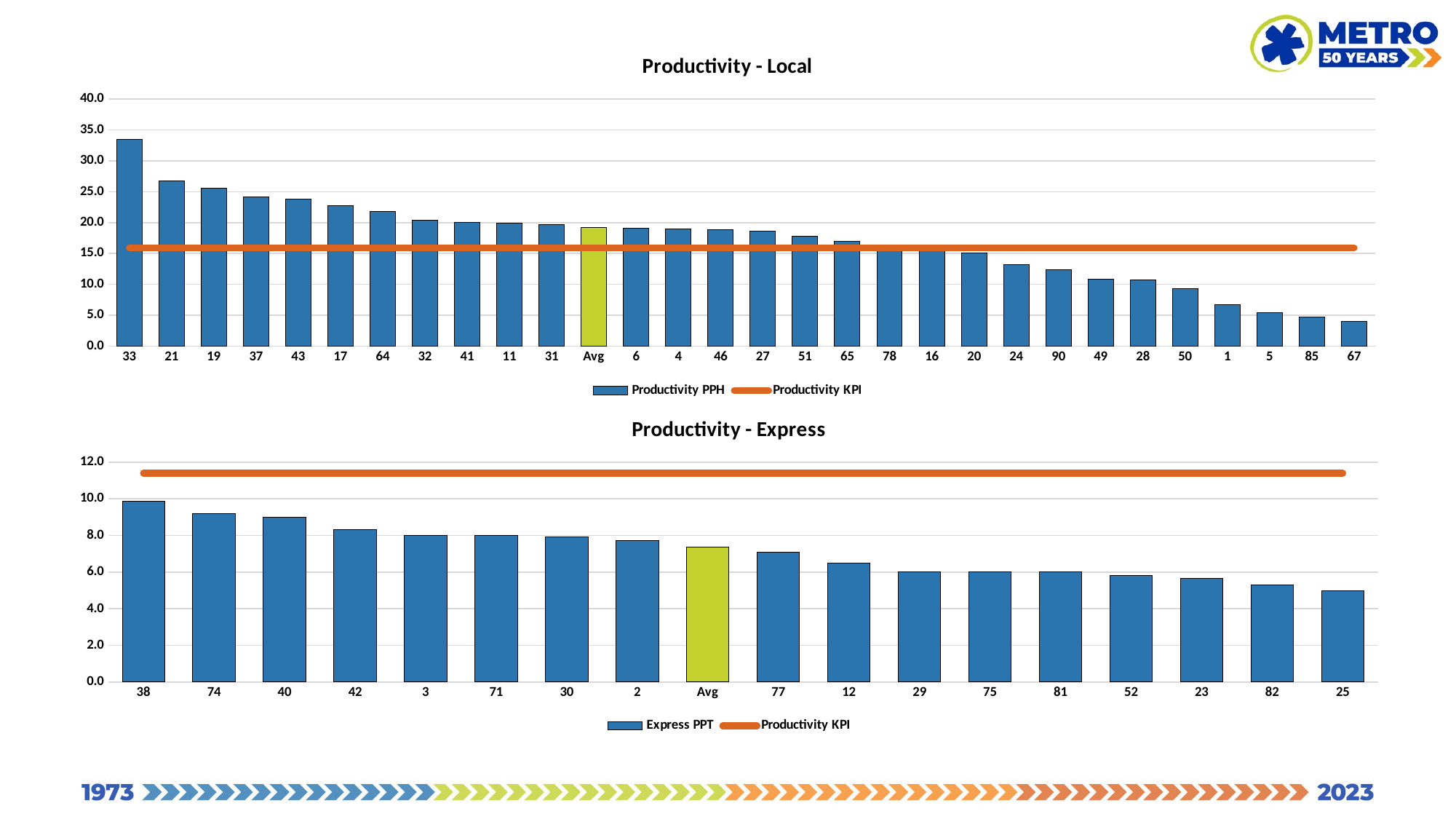
In the 'Productivity - Local' chart, which category has the lowest Productivity PPH? 67 In the 'Productivity - Local' chart, is the value for category 33 greater or less than 30.0? greater In the 'Productivity - Local' chart, which category has the highest Productivity PPH? 33 In the 'Productivity - Express' chart, is the value for category 25 greater or less than 6.0? less How many series does the legend of the 'Productivity - Local' chart list? 2 In the 'Productivity - Local' chart, is the value for category 24 greater or less than 15.0? less How many categories are shown on the x axis of the 'Productivity - Local' chart? 30 What kind of chart is the 'Productivity - Local' chart? bar chart In the 'Productivity - Express' chart, which category has the lowest Express PPT? 25 In the 'Productivity - Express' chart, do the Express PPT bars rise or fall from left to right? fall How many categories are shown on the x axis of the 'Productivity - Express' chart? 18 In the 'Productivity - Express' chart, which category has the highest Express PPT? 38